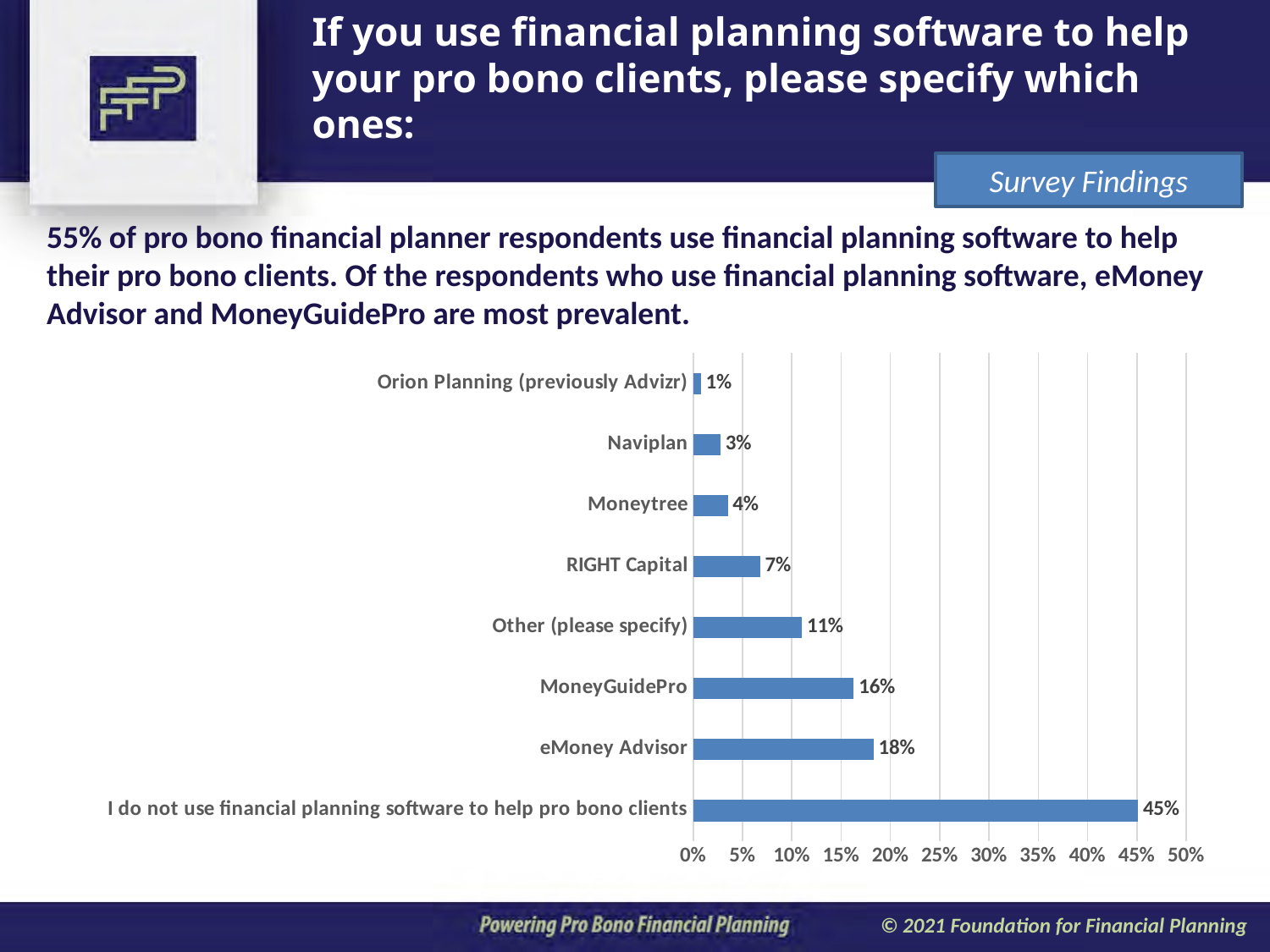
What is the value for 'I do not use financial planning software to help pro bono clients'? 45% What percentage is shown for RIGHT Capital? 7% How many categories are shown in the chart? 8 What percentage of respondents use eMoney Advisor? 18% Which category has the lowest value in the chart? Orion Planning (previously Advizr) What is the highest value shown on the x axis of the chart? 50% Which category has the highest value in the chart? I do not use financial planning software to help pro bono clients What is the difference between the values for eMoney Advisor and MoneyGuidePro? 2% Which has a larger value, Other (please specify) or RIGHT Capital? Other (please specify) What type of chart is shown on the slide? Bar chart What is the value shown for MoneyGuidePro? 16% What is the difference between the values for Naviplan and Moneytree? 1%